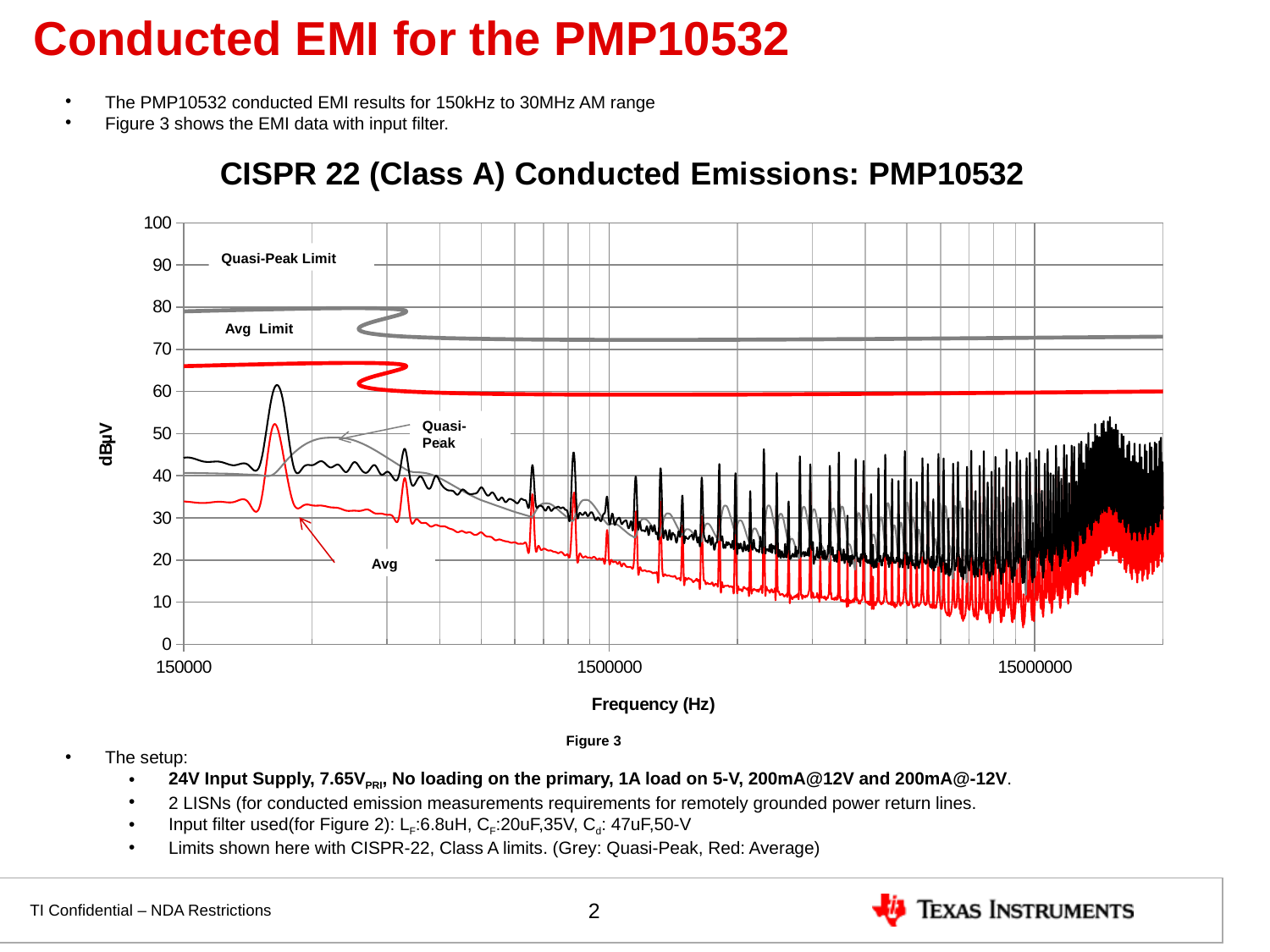
Which measurement trace is higher at 150000 Hz, the Quasi-Peak trace or the Avg trace? Quasi-Peak Is the Quasi-Peak Limit line at 1500000 Hz greater or less than 80 dBµV? less What is the label of the x axis of the chart? Frequency (Hz) What kind of chart is shown on the slide? line chart Is the Avg Limit line at 15000000 Hz greater or less than 70 dBµV? less Is the Quasi-Peak Limit line at 150000 Hz greater or less than 70 dBµV? greater Which is higher at 1500000 Hz, the Quasi-Peak Limit line or the Avg Limit line? Quasi-Peak Limit What is the highest value shown on the y axis of the chart? 100 What is the title of the chart? CISPR 22 (Class A) Conducted Emissions: PMP10532 Does the Avg Limit line rise or fall as frequency increases from 150000 Hz to 15000000 Hz? fall